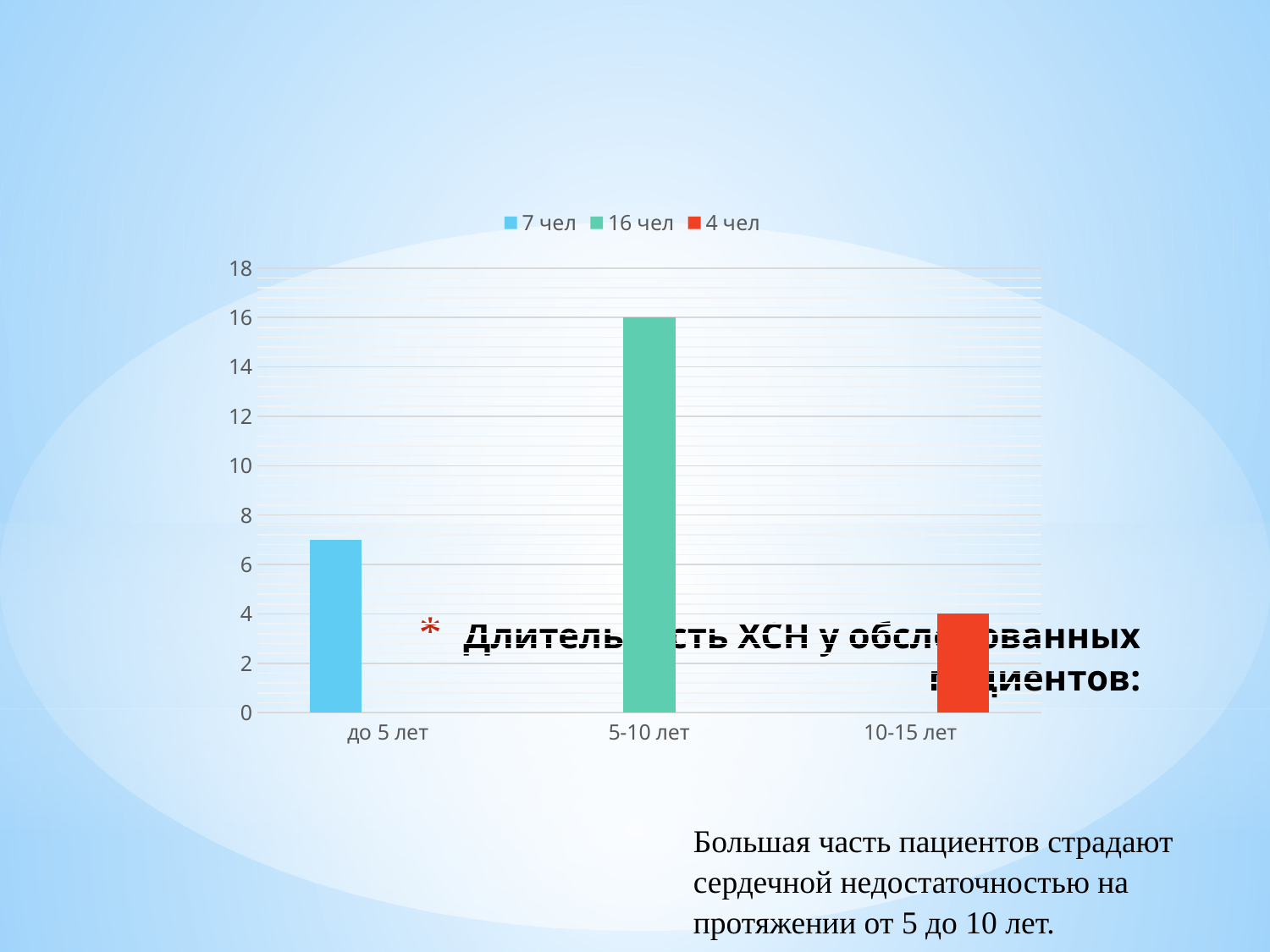
How many categories are shown on the x axis? 3 What is the value for the category "5-10 лет"? 16 Which category has the lowest value? 10-15 лет Is the value for "5-10 лет" greater or less than 10? greater Which is larger, the value for "до 5 лет" or the value for "10-15 лет"? до 5 лет What is the value for the category "10-15 лет"? 4 What is the value for the category "до 5 лет"? 7 What kind of chart is shown on the slide? bar chart How many entries does the legend list? 3 What is the difference between the values for "5-10 лет" and "до 5 лет"? 9 Which category has the highest value? 5-10 лет What is the difference between the values for "5-10 лет" and "10-15 лет"? 12